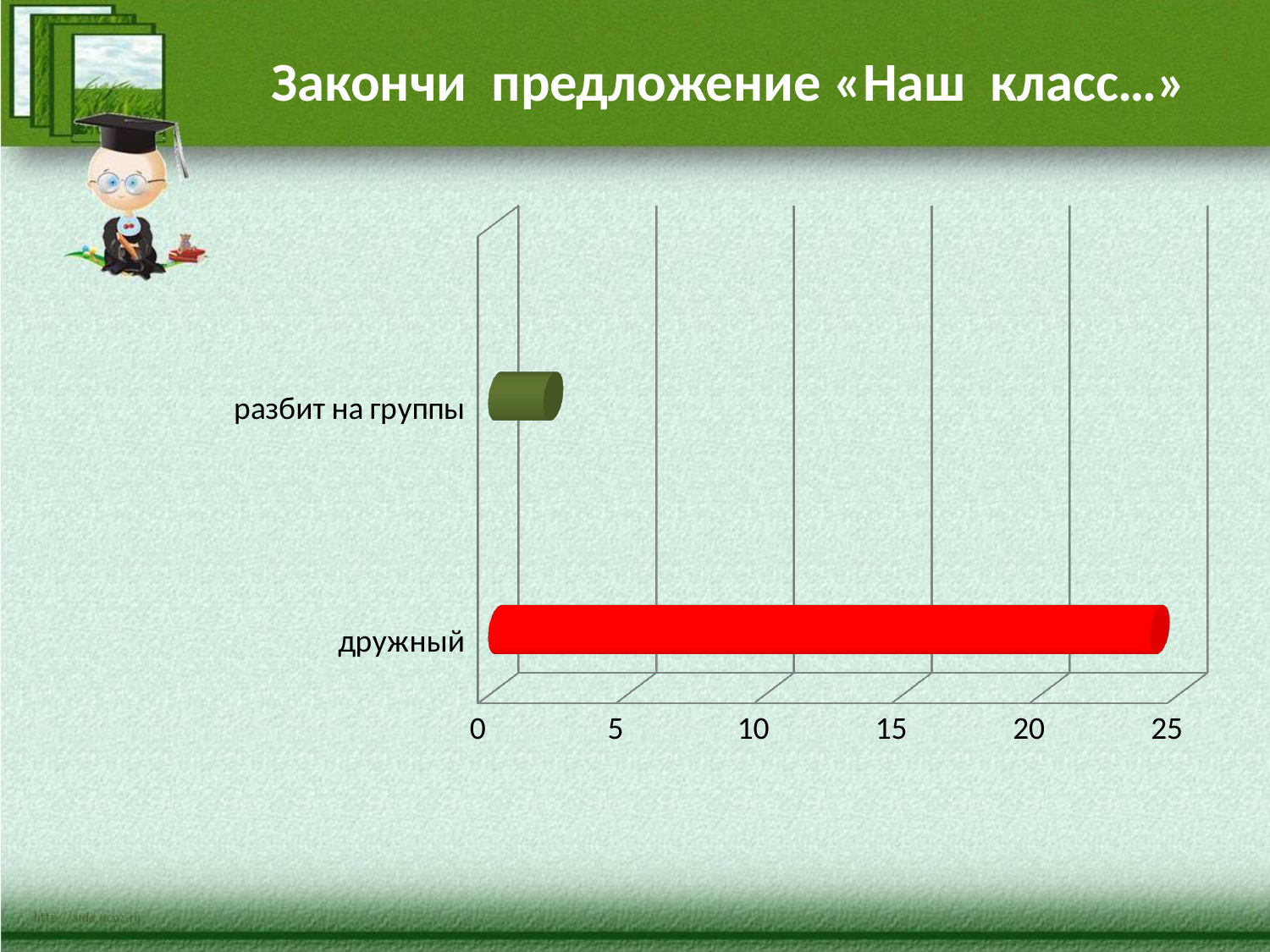
Which is larger: the value for «дружный» or the value for «разбит на группы»? дружный Is the value for «разбит на группы» greater or less than 5? less Is the value for «разбит на группы» greater or less than 10? less How many categories are plotted in the chart? 2 What kind of chart is shown on the slide? bar chart Is the value for «дружный» greater or less than 20? greater What colour is the bar for «дружный»? red Which category has the highest value in the chart? дружный What is the highest value shown on the horizontal axis of the chart? 25 Which category has the lowest value in the chart? разбит на группы